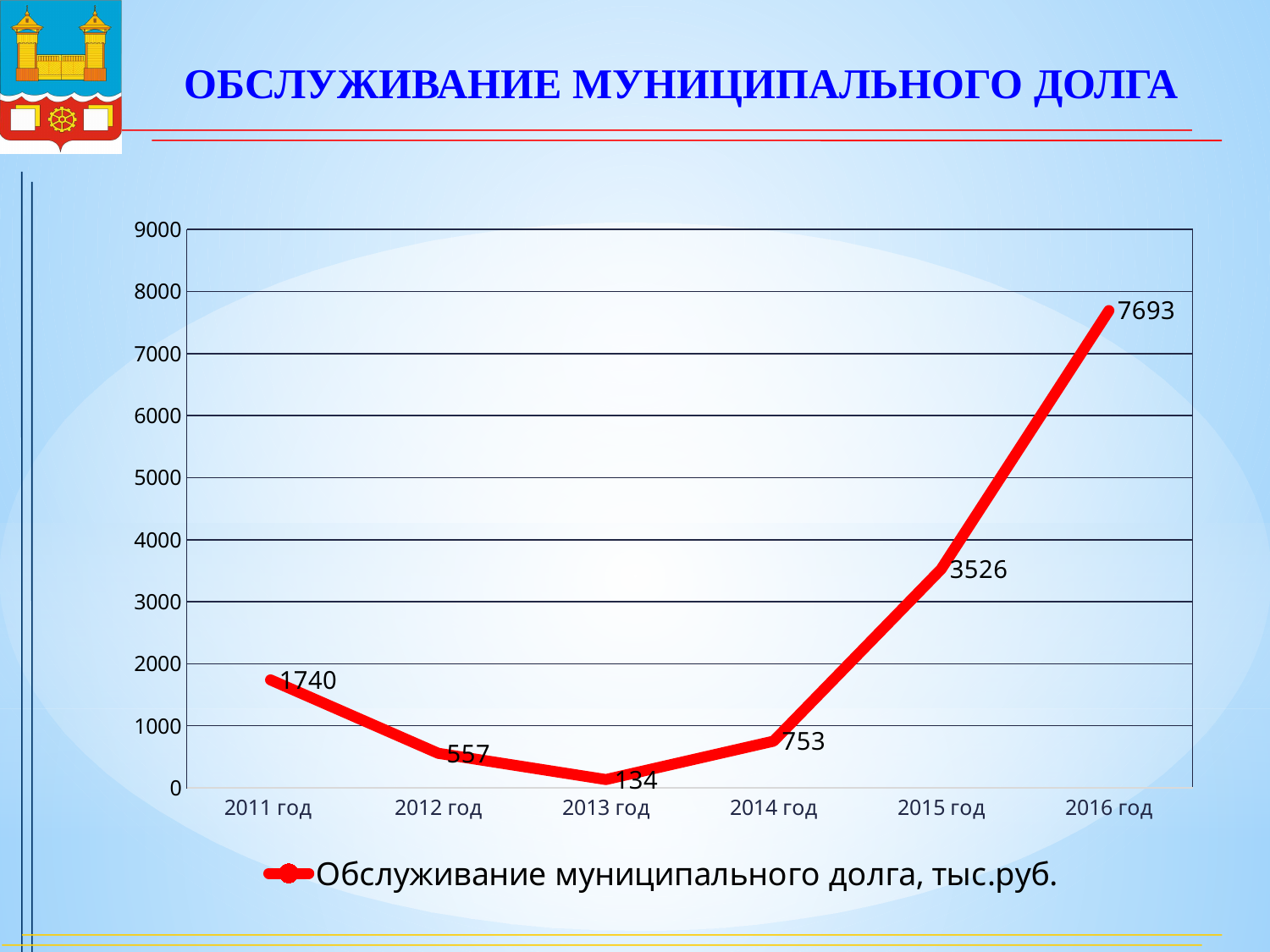
What is the legend entry for the plotted series? Обслуживание муниципального долга, тыс.руб. Which year has the lowest value? 2013 год What is the difference between the values for 2011 год and 2012 год? 1183 How many years are plotted on the chart? 6 What is the difference between the values for 2016 год and 2015 год? 4167 What is the value for 2011 год? 1740 What is the value for 2013 год? 134 What kind of chart is shown on the slide? line chart Which is larger, the value for 2014 год or the value for 2012 год? 2014 год Is the value for 2016 год greater or less than 7000? greater Which year has the highest value? 2016 год What is the value for 2015 год? 3526